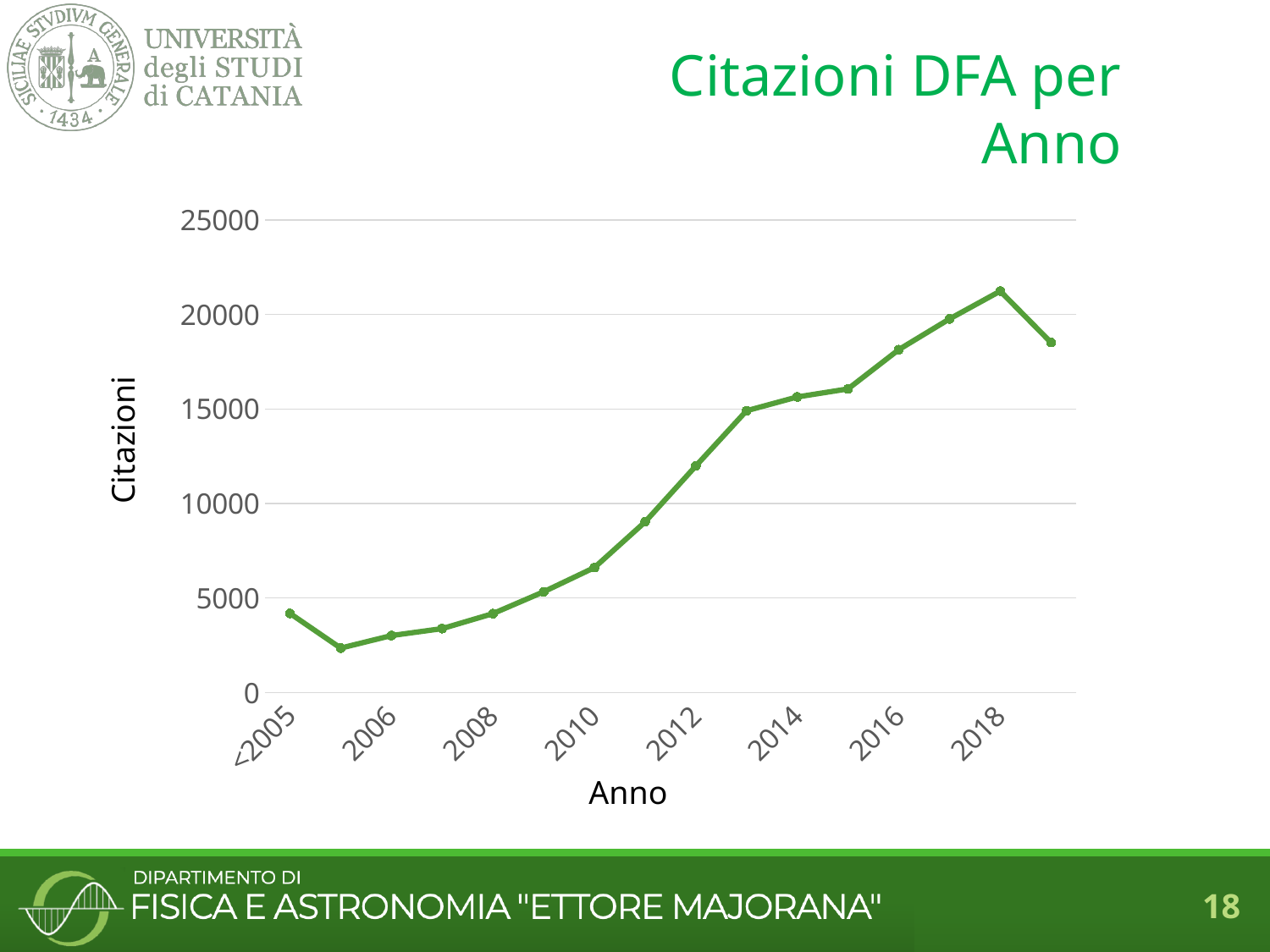
Do the citations generally rise or fall from 2006 to 2018? rise What is the label of the vertical axis? Citazioni Is the value for 2016 greater or less than 15000? greater Which year has the highest number of citations? 2018 Which is larger, the value for 2016 or the value for 2018? 2018 Is the value for 2012 greater or less than 10000? greater What kind of chart is shown on the slide? line chart Is the value for <2005 greater or less than 5000? less What is the title of the chart? Citazioni DFA per Anno Which is larger, the value for 2006 or the value for 2010? 2010